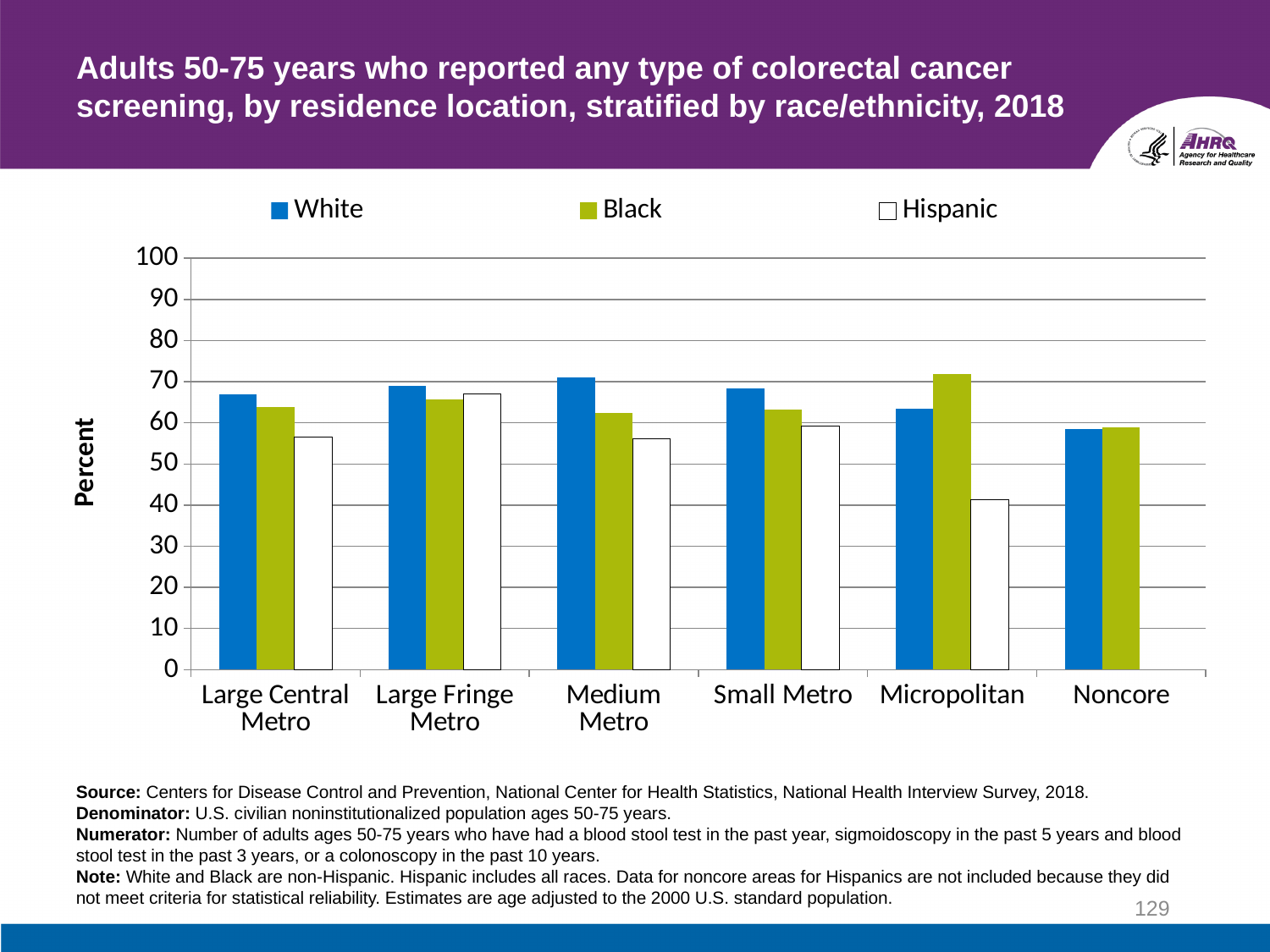
Is the White value for Medium Metro greater or less than 60? greater Is the Hispanic value for Micropolitan greater or less than 50? less For which residence location is the Hispanic value lowest? Micropolitan What is the label on the y axis? Percent What kind of chart is shown on the slide? bar chart Which is larger, the White value for Medium Metro or the White value for Micropolitan? Medium Metro In Micropolitan areas, which is larger, the White value or the Black value? Black How many series does the legend list? 3 Is the Hispanic value for Large Central Metro greater or less than 60? less Which residence location category has no Hispanic bar? Noncore How many residence location categories are shown on the x axis? 6 For which residence location is the Black value highest? Micropolitan